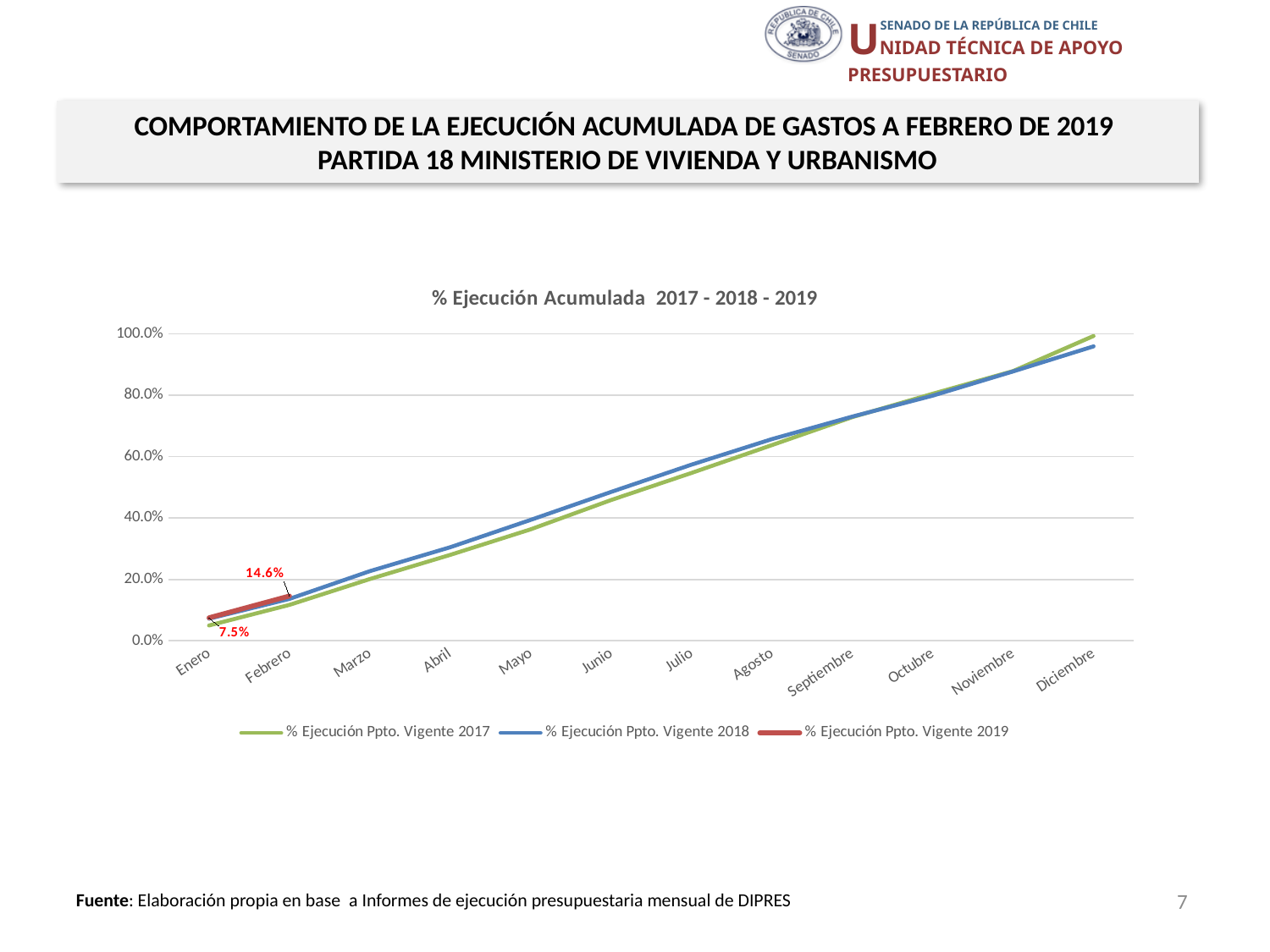
Is the value for % Ejecución Ppto. Vigente 2017 in Marzo greater or less than 40%? less What is the value of % Ejecución Ppto. Vigente 2019 for Febrero? 14.6% Do the values of % Ejecución Ppto. Vigente 2017 rise or fall from Enero to Diciembre? Rise What kind of chart is shown on the slide? Line chart How many months are shown on the x axis of the chart? 12 What is the value of % Ejecución Ppto. Vigente 2019 for Enero? 7.5% Which is larger for % Ejecución Ppto. Vigente 2019: the Enero value or the Febrero value? Febrero What is the difference between the Febrero and Enero values of % Ejecución Ppto. Vigente 2019? 7.1% How many series does the chart legend list? 3 What colour is the line for % Ejecución Ppto. Vigente 2019? Red Is the value for % Ejecución Ppto. Vigente 2018 in Diciembre greater or less than 80%? greater What is the title of the chart? % Ejecución Acumulada 2017 - 2018 - 2019